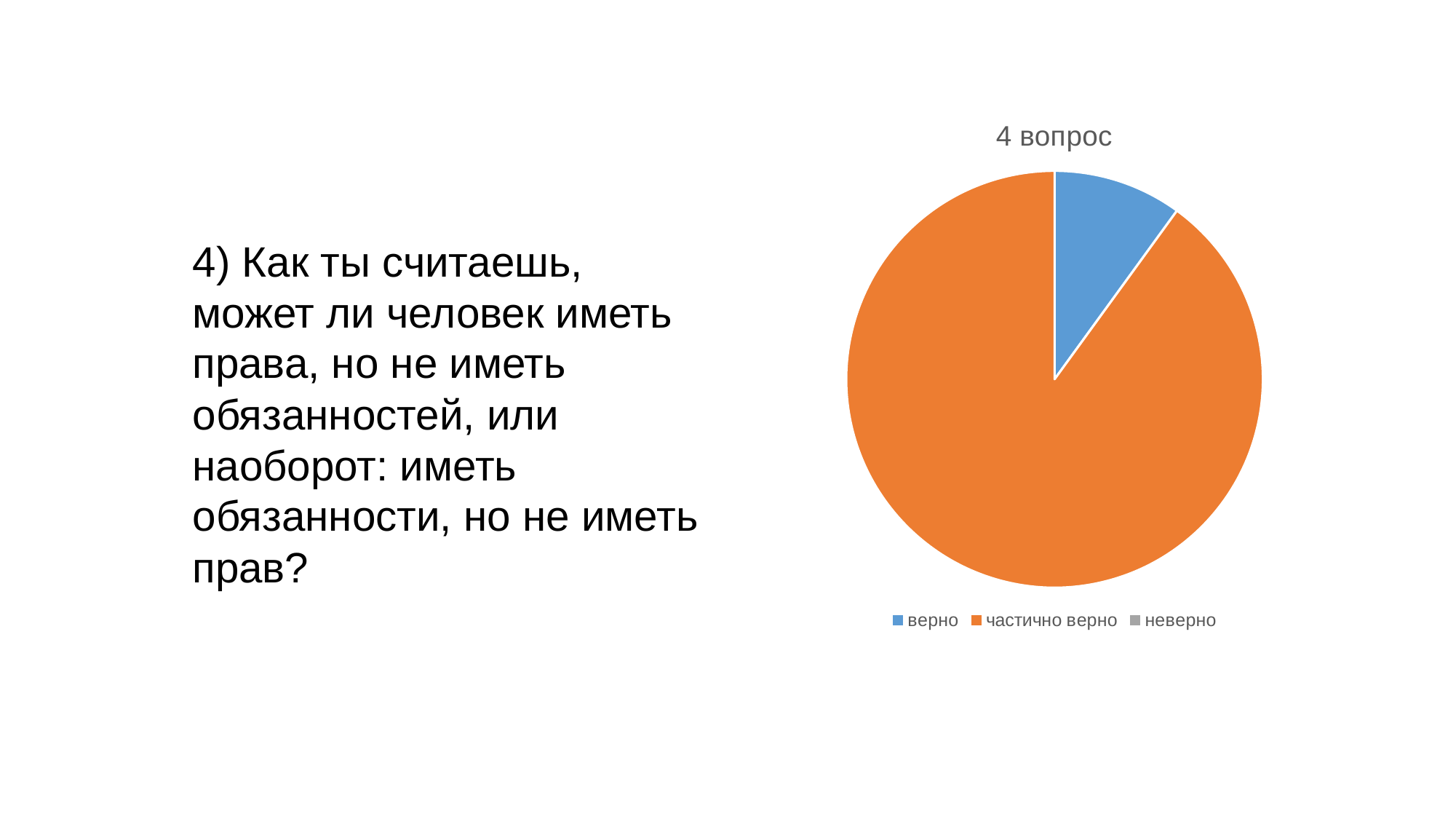
What colour is the slice for верно? blue What kind of chart is shown on the slide? pie chart Which of the two visible slices, верно or частично верно, is smaller? верно Which category is shown in orange in the legend? частично верно Which category has the largest slice of the pie? частично верно How many entries does the chart legend list? 3 What is the title of the chart? 4 вопрос Which slice is larger, верно or частично верно? частично верно